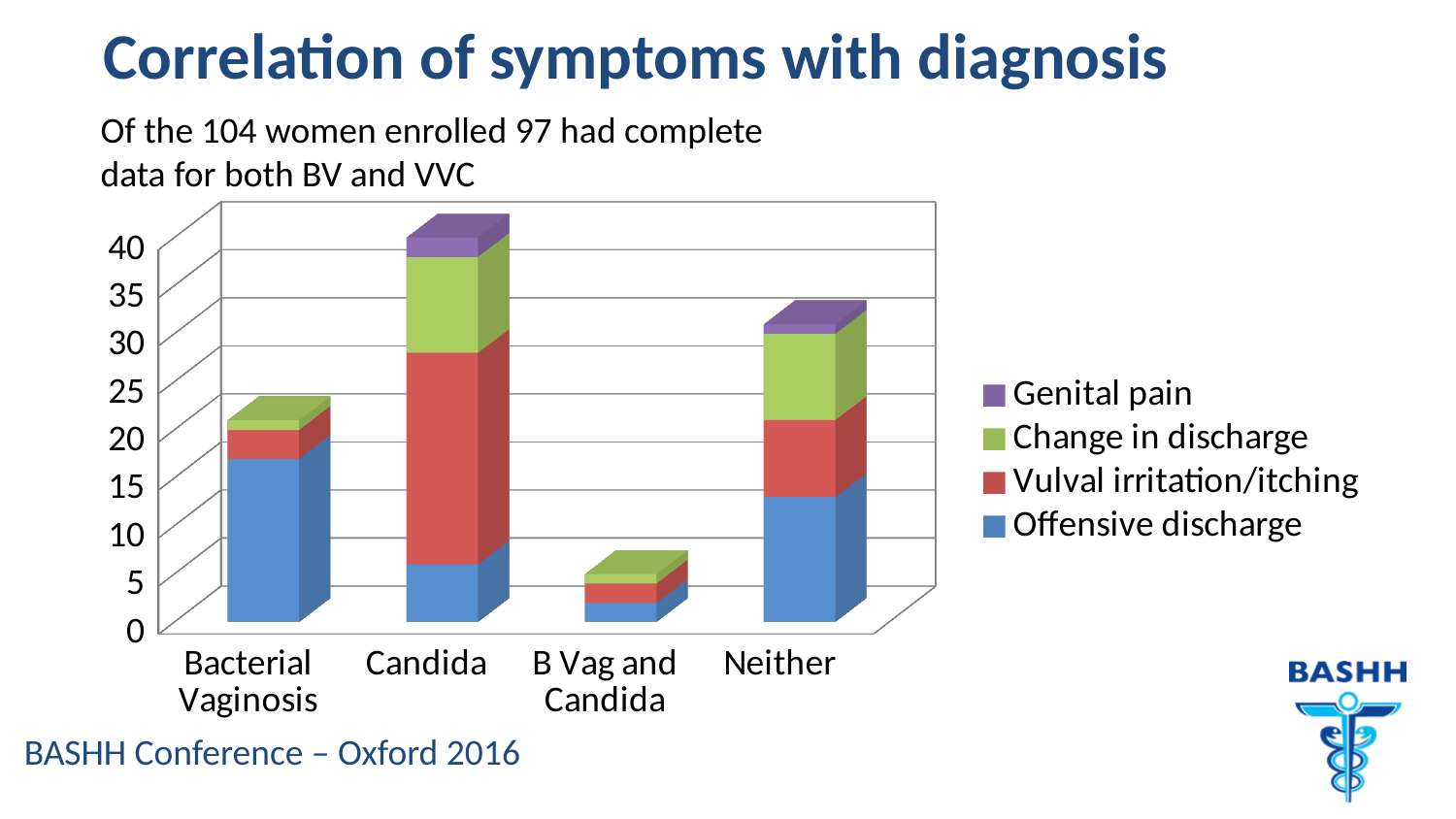
Which legend entry is shown in purple? Genital pain Is the total stacked bar for Neither greater or less than 25? greater How many series does the legend list? 4 Is the Offensive discharge segment for Bacterial Vaginosis greater or less than 10? greater Which diagnosis category has the shortest stacked bar? B Vag and Candida Is the total stacked bar for B Vag and Candida greater or less than 10? less Which has the taller stacked bar, Neither or Bacterial Vaginosis? Neither How many diagnosis categories are shown on the x axis? 4 Which series is shown at the bottom of each stacked bar? Offensive discharge What kind of chart is shown on the slide? stacked bar chart Which diagnosis category has the tallest stacked bar? Candida